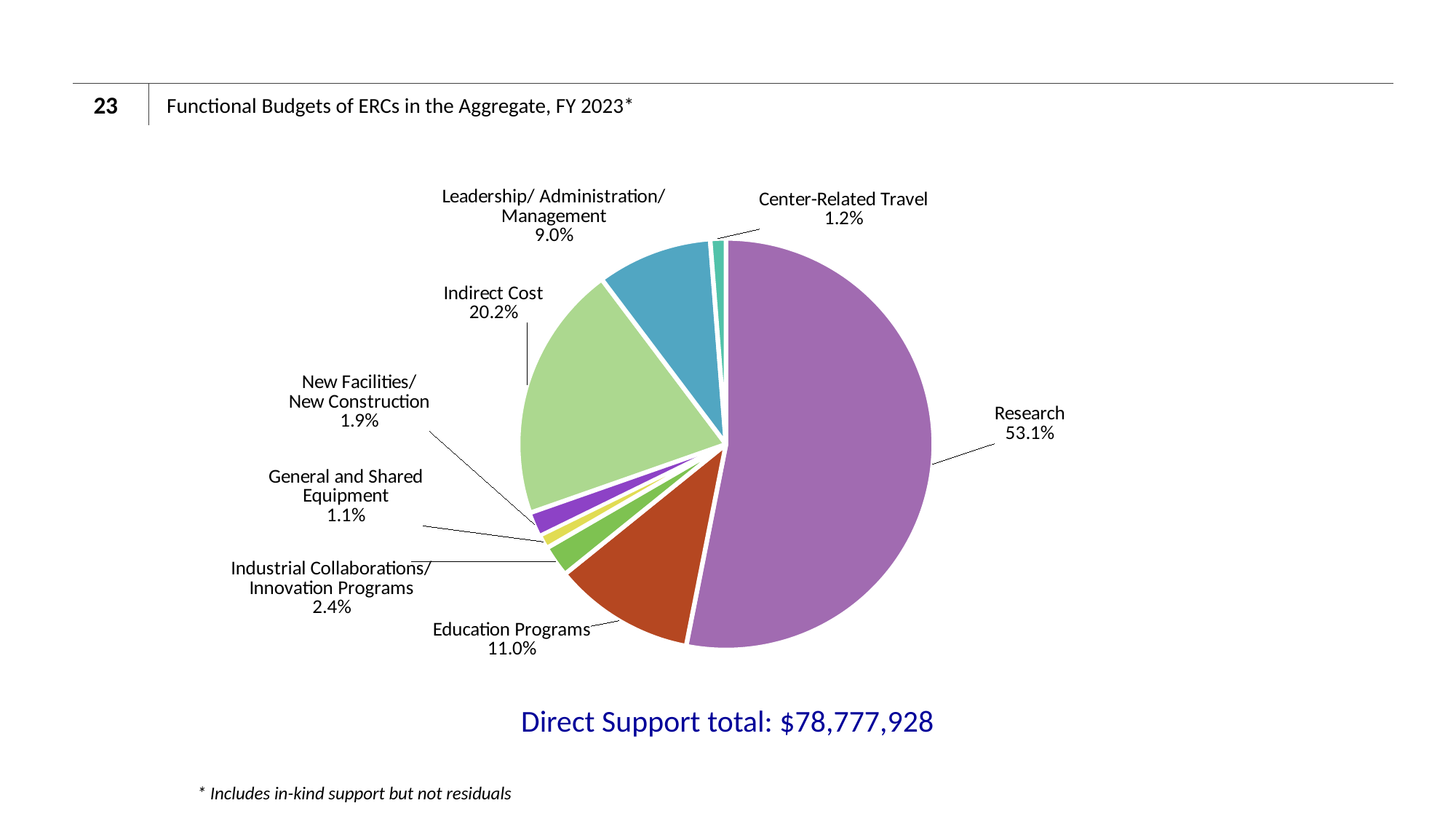
What is the Direct Support total stated below the chart? $78,777,928 How many categories are shown in the pie chart? 8 What is the title of the slide? Functional Budgets of ERCs in the Aggregate, FY 2023* What percentage is shown for Education Programs? 11.0% What is the value shown for Indirect Cost? 20.2% What share of the pie does Research account for? 53.1% What is the difference between the Research share and the Indirect Cost share? 32.9% Which category has the largest slice of the pie? Research Which category has the smallest slice of the pie? General and Shared Equipment Which is larger, Education Programs or Leadership/ Administration/ Management? Education Programs What kind of chart is shown on the slide? Pie chart What is the value for Leadership/ Administration/ Management? 9.0%